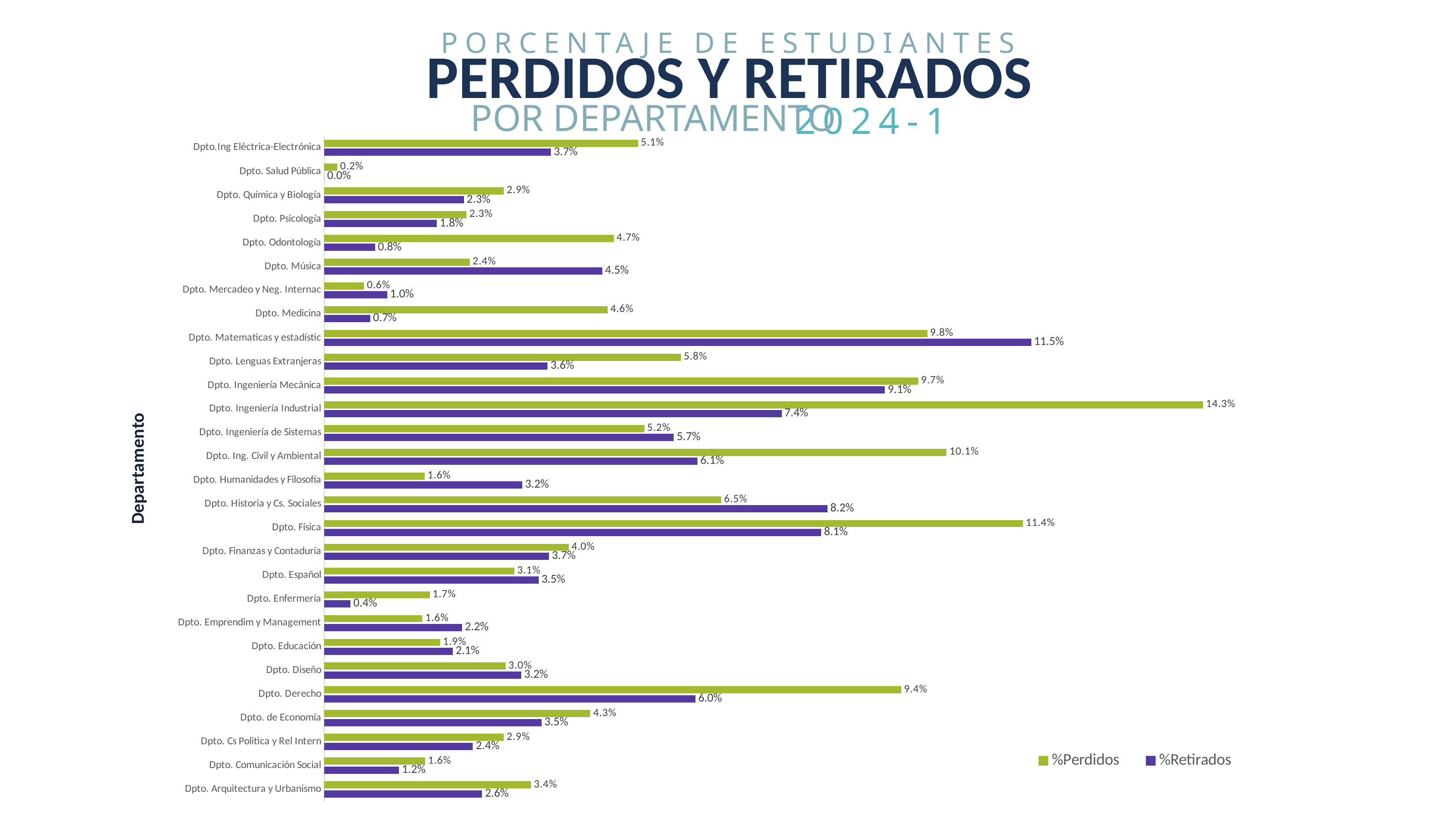
What is the difference between %Perdidos and %Retirados for Dpto. Ingeniería Industrial? 6.9% What is the %Retirados value for Dpto. Música? 4.5% Which department has the highest %Perdidos value? Dpto. Ingeniería Industrial How many series does the legend list? 2 What is the %Retirados value for Dpto. Matematicas y estadístic? 11.5% Which department has the lowest %Perdidos value? Dpto. Salud Pública Which department has the highest %Retirados value? Dpto. Matematicas y estadístic How many departments are shown on the chart? 28 What is the %Perdidos value for Dpto. Ingeniería Industrial? 14.3% Which is larger for Dpto. Física: %Perdidos or %Retirados? %Perdidos What kind of chart is shown on the slide? Bar chart Which is larger for Dpto. Historia y Cs. Sociales: %Perdidos or %Retirados? %Retirados